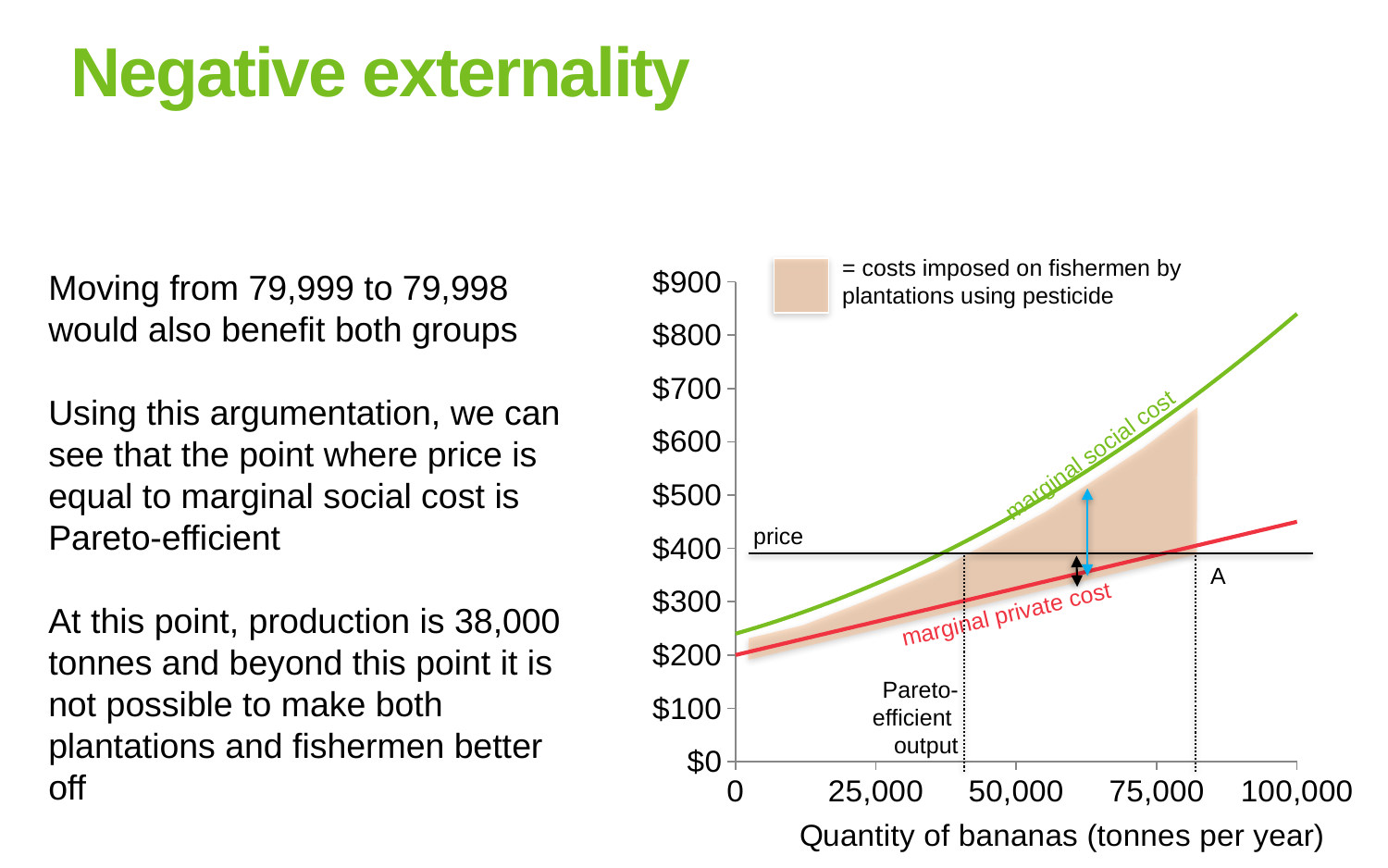
Does the marginal private cost line rise or fall as the quantity of bananas increases? rise Is the marginal social cost at 100,000 tonnes greater or less than $800? greater Is the marginal private cost at 100,000 tonnes greater or less than $500? less At 75,000 tonnes, which is higher: marginal social cost or marginal private cost? marginal social cost Does the marginal social cost curve rise or fall as the quantity of bananas increases? rise What is the highest value shown on the y axis of the chart? $900 Is the marginal social cost at 50,000 tonnes greater or less than $400? greater How many labelled lines (curves) are plotted on the chart? 3 What kind of chart is shown on the slide? line chart According to the legend, what does the shaded area represent? costs imposed on fishermen by plantations using pesticide What is the title of the x axis of the chart? Quantity of bananas (tonnes per year)